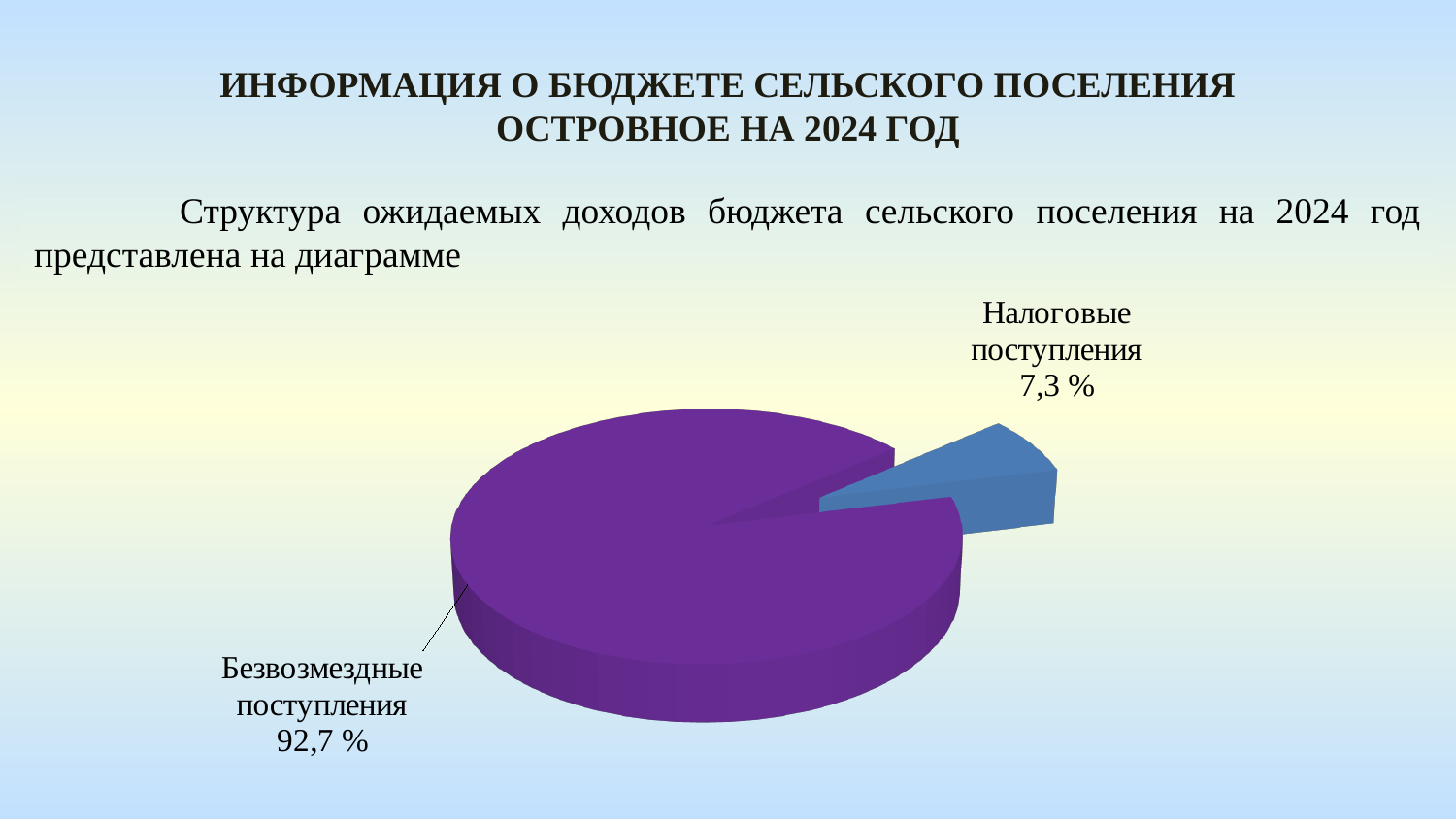
What share of the pie is labelled for Налоговые поступления? 7,3 % What colour is the slice for Налоговые поступления? Blue What kind of chart is shown on the slide? Pie chart Which slice of the pie is the smallest? Налоговые поступления What is the combined share of the two slices in the pie chart? 100 % By how many percentage points does Безвозмездные поступления exceed Налоговые поступления? 85,4 How many slices does the pie chart have? 2 What colour is the slice for Безвозмездные поступления? Purple Which is larger: Безвозмездные поступления or Налоговые поступления? Безвозмездные поступления What share of the pie is labelled for Безвозмездные поступления? 92,7 % Which slice of the pie is the largest? Безвозмездные поступления